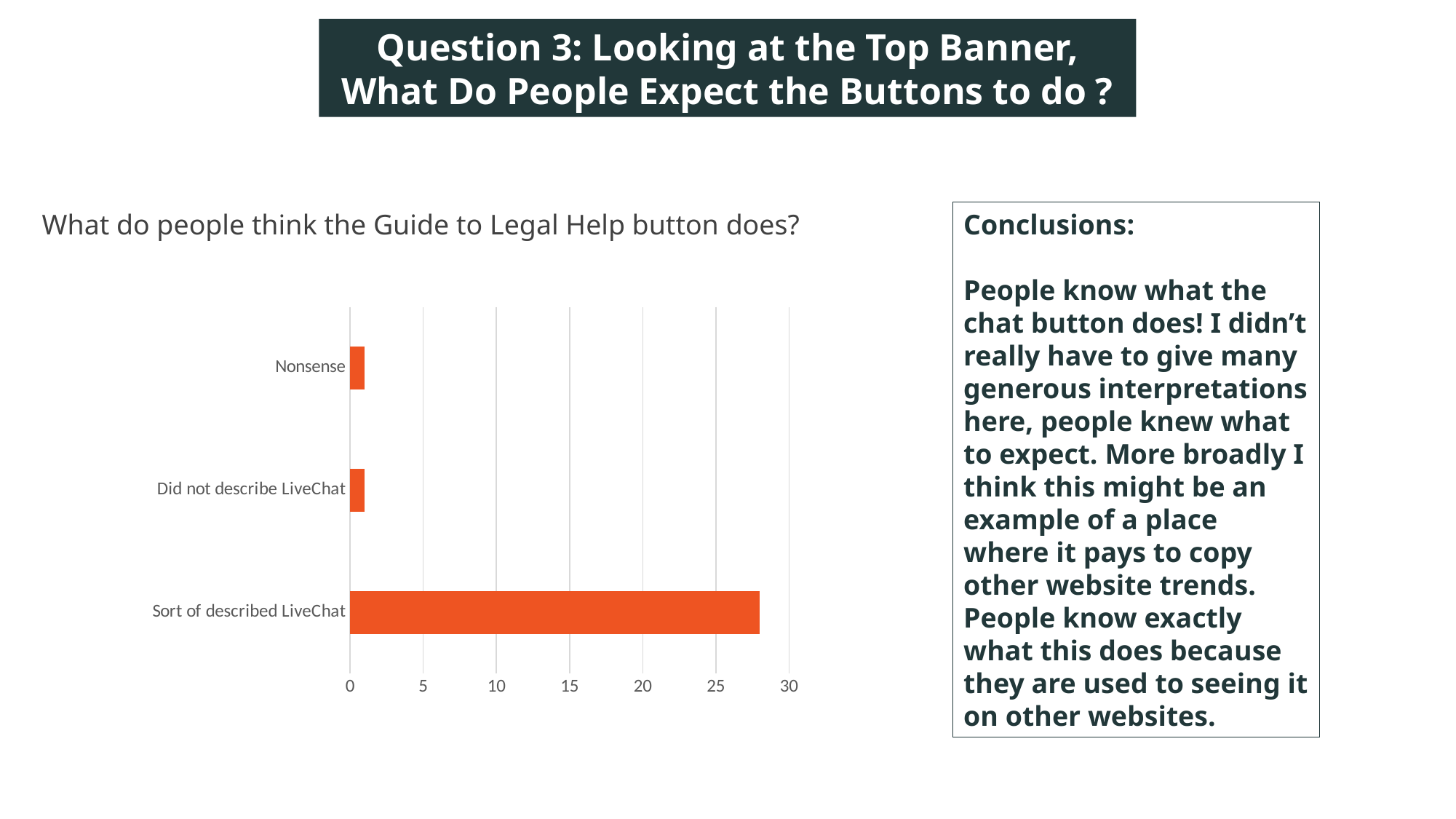
How many categories does the chart show? 3 What kind of chart is shown on the slide? bar chart Which is larger, the value for Sort of described LiveChat or the value for Nonsense? Sort of described LiveChat Which category has the highest value? Sort of described LiveChat What is the highest value shown on the chart's horizontal axis? 30 Is the value for Nonsense greater or less than 5? less Which is larger, the value for Did not describe LiveChat or the value for Sort of described LiveChat? Sort of described LiveChat Is the value for Sort of described LiveChat greater or less than 30? less Is the value for Sort of described LiveChat greater or less than 25? greater What is the title of the chart? What do people think the Guide to Legal Help button does? What colour are the bars in the chart? orange